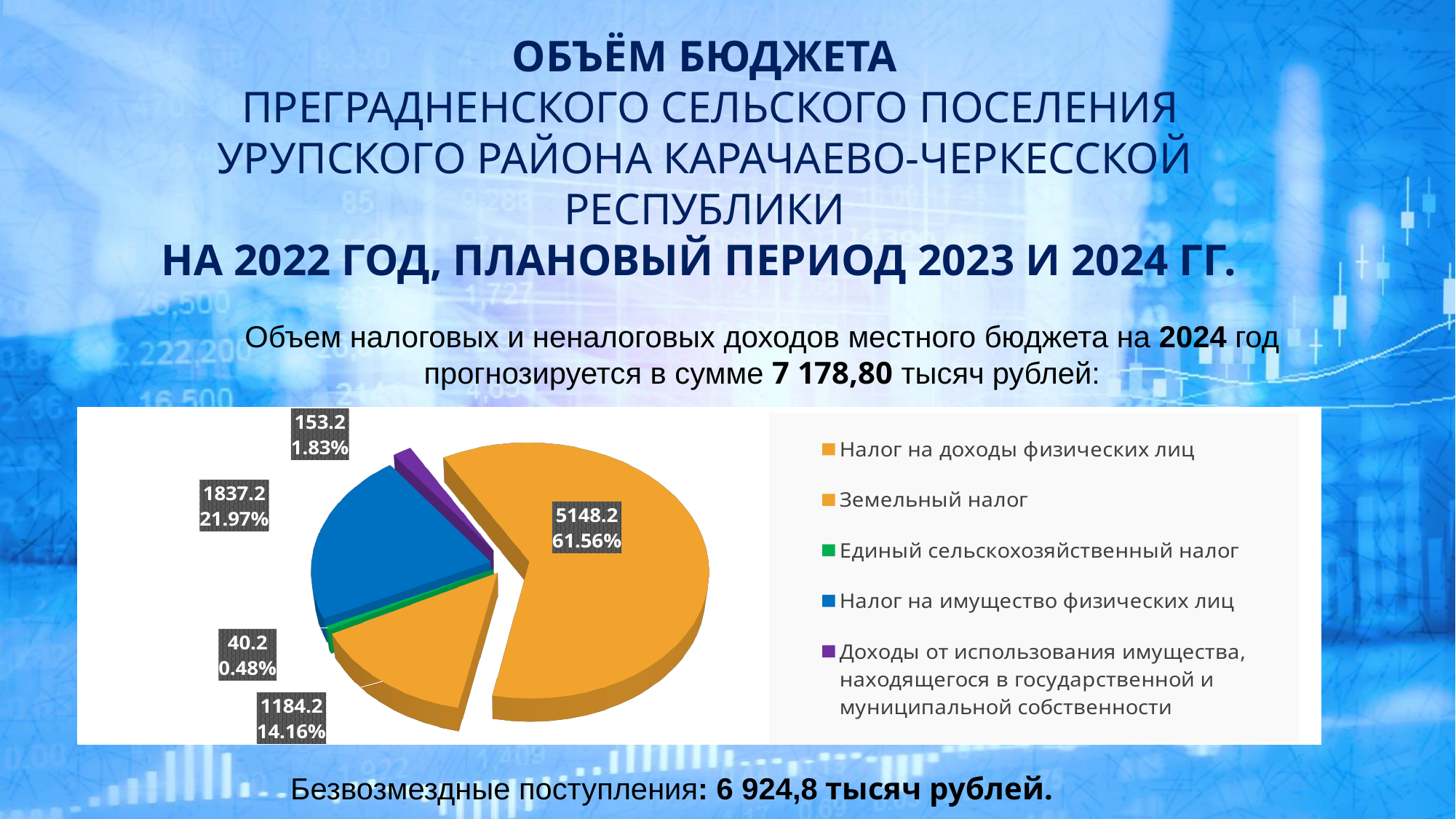
What kind of chart is shown on the slide? pie chart What is the difference between the values for Налог на имущество физических лиц and Земельный налог? 653.0 How many entries does the legend of the pie chart list? 5 What share of the pie does Налог на доходы физических лиц represent? 61.56% How many slices does the pie chart have? 5 Which is larger: Налог на имущество физических лиц or Земельный налог? Налог на имущество физических лиц What value is shown for Налог на имущество физических лиц? 1837.2 What value is shown for Налог на доходы физических лиц in the pie chart? 5148.2 What share of the pie does Земельный налог represent? 14.16% Which category has the smallest slice in the pie chart? Единый сельскохозяйственный налог What value is shown for Единый сельскохозяйственный налог? 40.2 Which category has the largest slice in the pie chart? Налог на доходы физических лиц